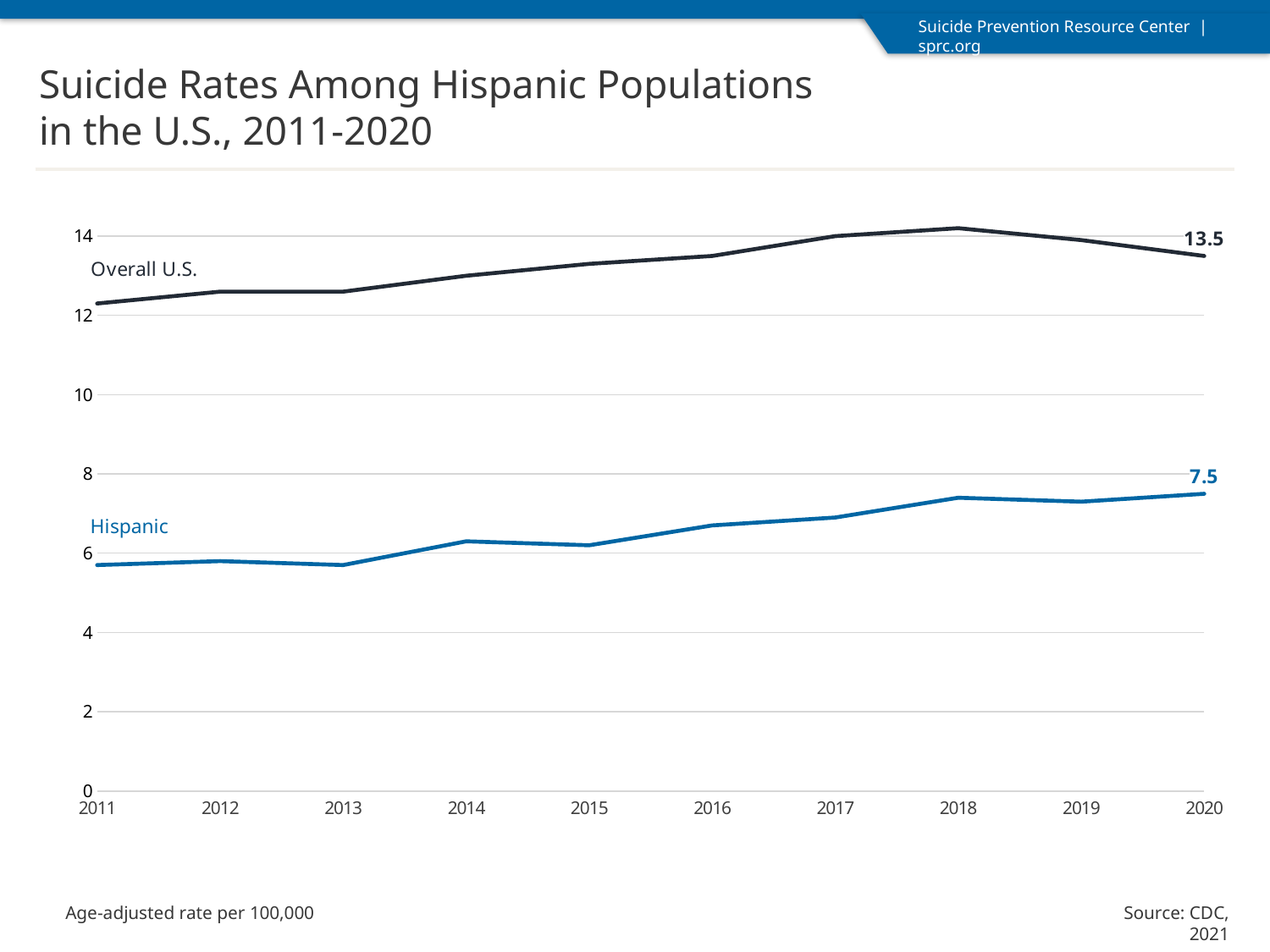
Is the Hispanic rate in 2011 greater or less than 6? less What kind of chart is shown on the slide? Line chart In which year does the Overall U.S. line reach its highest point? 2018 Is the Hispanic rate in 2018 greater or less than 8? less What is the Hispanic suicide rate in 2020? 7.5 Does the Hispanic rate generally rise or fall from 2011 to 2020? Rise Which series has the higher value in 2020, Overall U.S. or Hispanic? Overall U.S. What is the difference between the Overall U.S. and Hispanic rates in 2020? 6.0 How many series are plotted on the chart? 2 How many years are shown on the x axis? 10 Is the Overall U.S. rate in 2018 greater or less than 14? greater What is the Overall U.S. suicide rate in 2020? 13.5